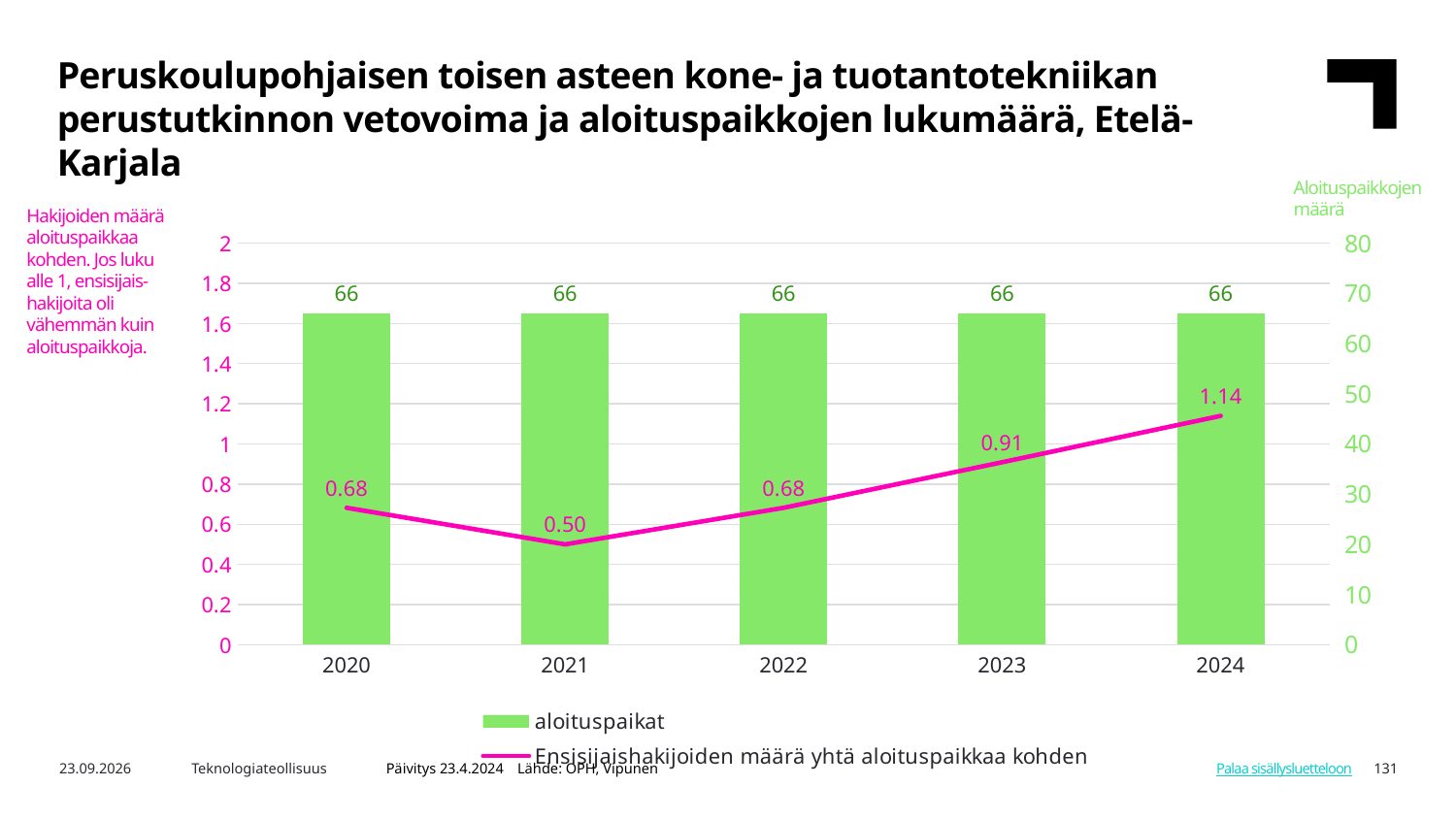
Which year has a larger 'Ensisijaishakijoiden määrä yhtä aloituspaikkaa kohden' value, 2020 or 2023? 2023 How many 'aloituspaikat' are shown for 2022? 66 Does the 'Ensisijaishakijoiden määrä yhtä aloituspaikkaa kohden' line rise or fall from 2021 to 2024? rise Is the 'Ensisijaishakijoiden määrä yhtä aloituspaikkaa kohden' value for 2023 greater or less than 1? less What is the value of the 'Ensisijaishakijoiden määrä yhtä aloituspaikkaa kohden' line for 2024? 1.14 In which year is the 'Ensisijaishakijoiden määrä yhtä aloituspaikkaa kohden' value highest? 2024 How many years are shown on the x axis of the chart? 5 What colour are the 'aloituspaikat' bars in the chart? green What is the difference between the 'Ensisijaishakijoiden määrä yhtä aloituspaikkaa kohden' values for 2024 and 2023? 0.23 In which year is the 'Ensisijaishakijoiden määrä yhtä aloituspaikkaa kohden' value lowest? 2021 How many series does the chart legend list? 2 What is the value of the 'Ensisijaishakijoiden määrä yhtä aloituspaikkaa kohden' line for 2021? 0.50